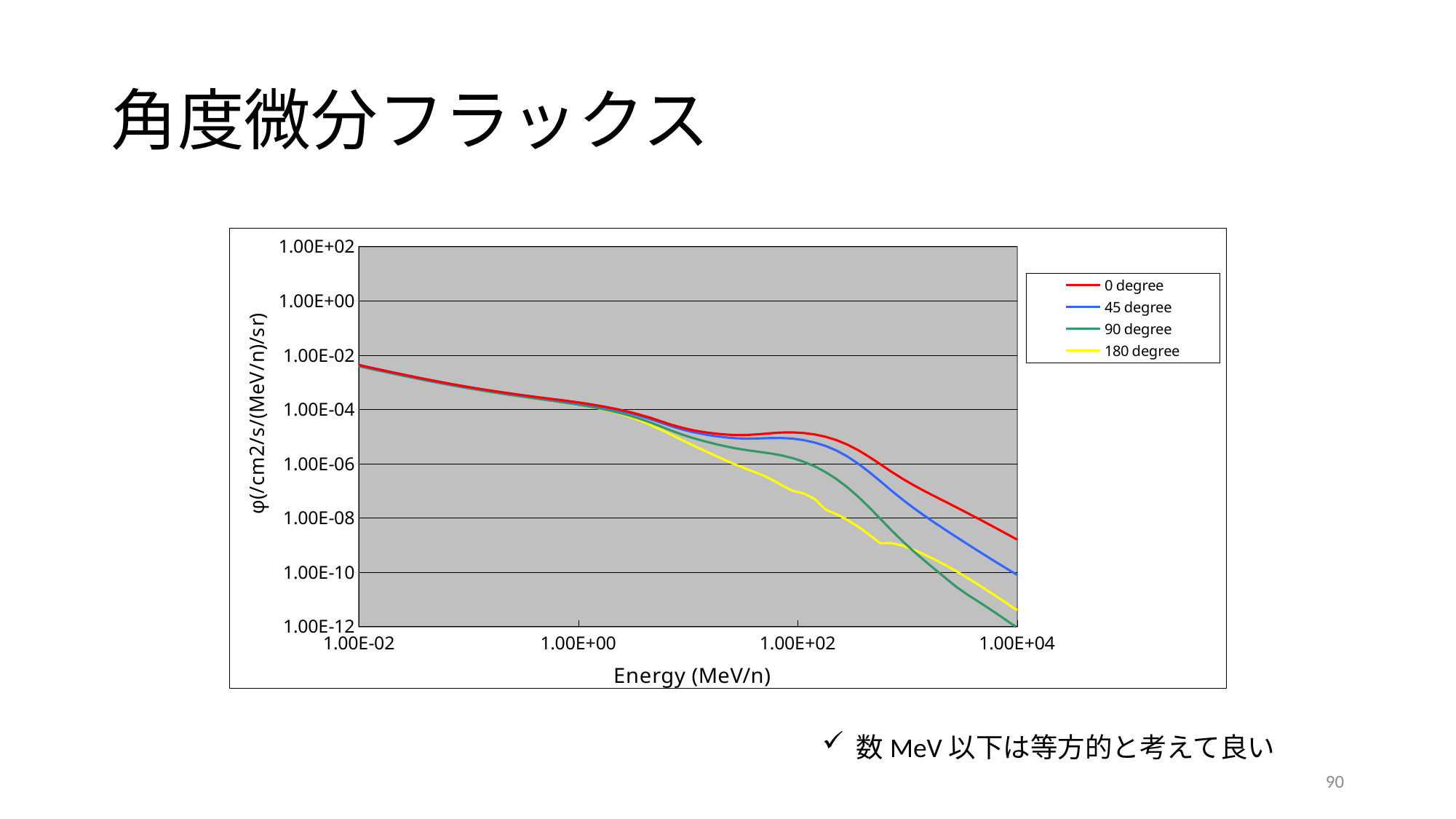
What is the label of the x axis? Energy (MeV/n) Which series has the lowest value at 1.00E+04 MeV/n? 90 degree At 1.00E+02 MeV/n, which is larger, the value for 45 degree or the value for 90 degree? 45 degree At 1.00E+04 MeV/n, is the value for 0 degree greater or less than 1.00E-10? greater How many series does the legend list? 4 Do the plotted values rise or fall as energy increases along the x axis? fall What are the series names listed in the legend? 0 degree, 45 degree, 90 degree, 180 degree At 1.00E+02 MeV/n, is the value for 180 degree greater or less than 1.00E-06? less Which series has the lowest value at 1.00E+02 MeV/n? 180 degree What kind of chart is shown on the slide? line chart At 1.00E+02 MeV/n, is the value for 0 degree greater or less than 1.00E-06? greater Which series has the highest value at 1.00E+04 MeV/n? 0 degree